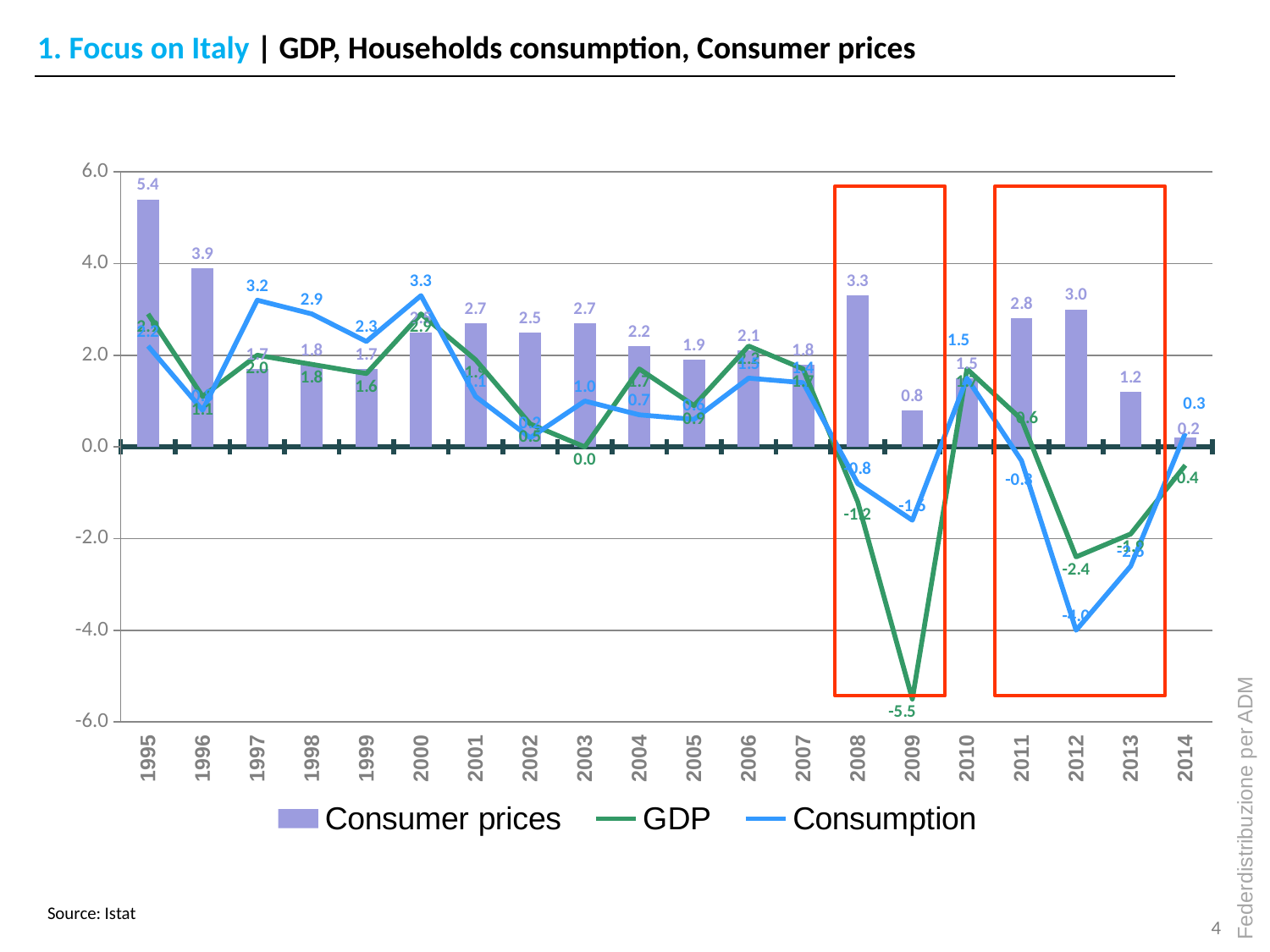
What source is cited for the chart data? Istat How many series does the legend list? 3 Do Consumer prices rise or fall from 2012 to 2014? Fall In which year is GDP at its lowest? 2009 What kind of chart is shown on the slide? A combined bar and line chart What is the Consumption value for 1997? 3.2 What is the GDP value for 2009? -5.5 In which year are Consumer prices at their highest? 1995 What is the Consumer prices value for 1995? 5.4 Which year has the higher Consumer prices value, 2008 or 2009? 2008 What is the difference between the Consumer prices values for 1995 and 1996? 1.5 How many years are shown on the x axis? 20